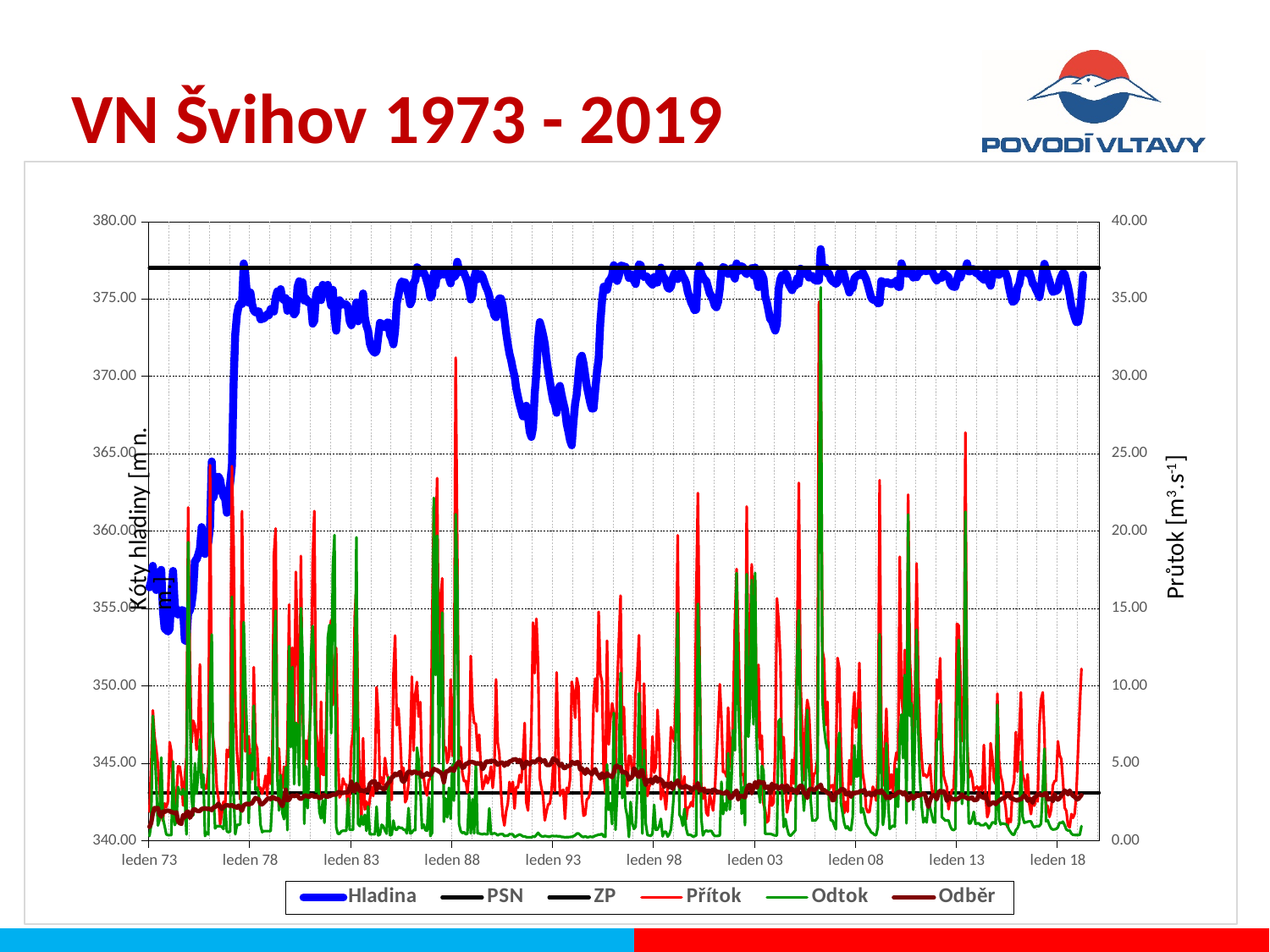
What is the title of the slide containing the chart? VN Švihov 1973 - 2019 Which colour is used for the Hladina series in the chart? blue Is the lowest Hladina value around leden 93 greater or less than 370.00 on the left axis? less Is the Hladina value at leden 08 greater or less than 375.00 on the left axis? greater Does the Hladina series rise or fall between leden 73 and leden 78? rise Is the Hladina value at leden 73 greater or less than 360.00 on the left axis? less How many series does the chart legend list? 6 How many year labels are shown along the x axis of the chart? 10 What kind of chart is shown on the slide? line chart